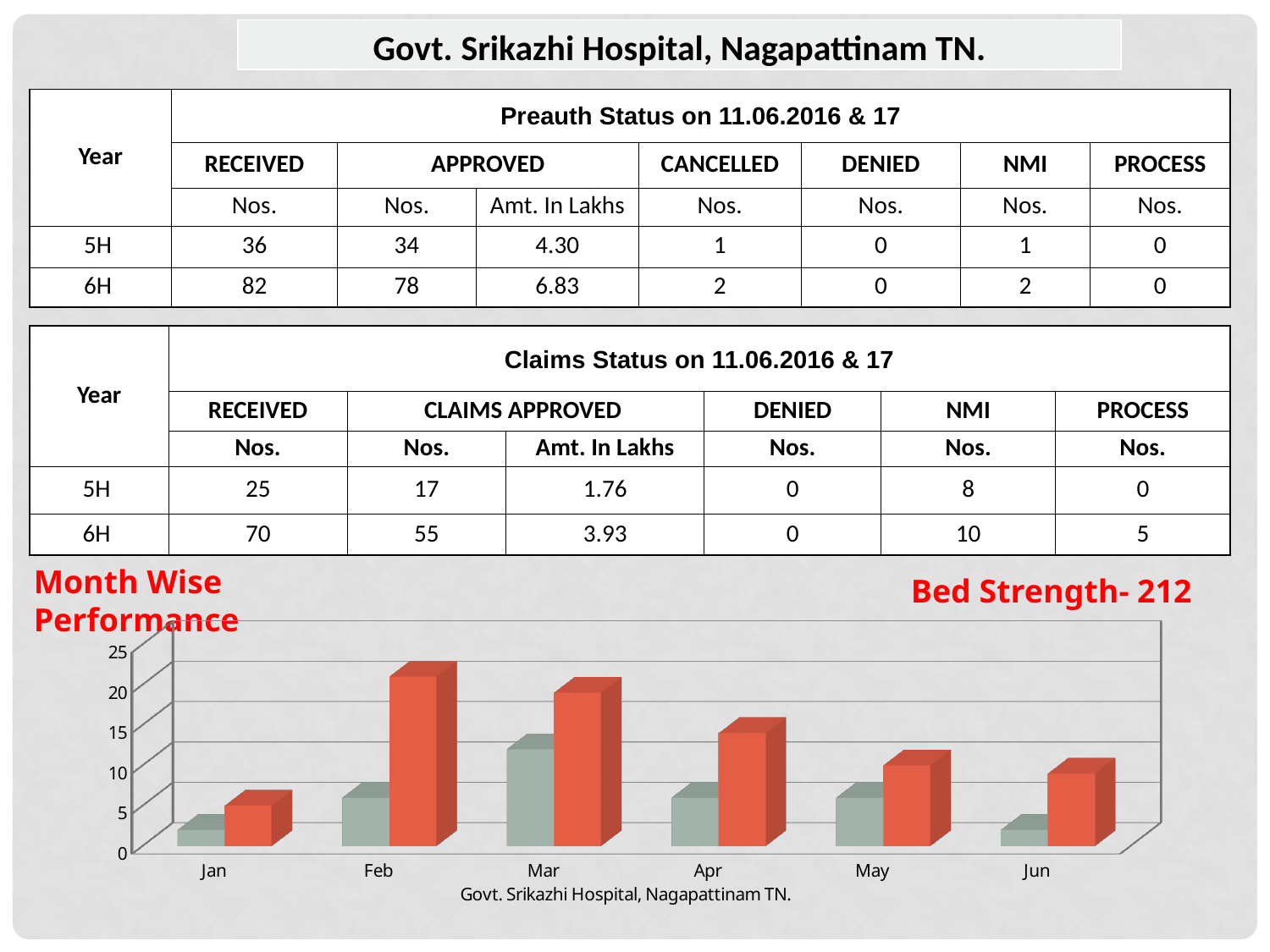
In the bar chart, which is larger for Mar: the red bar or the grey bar? the red bar What kind of chart is shown at the bottom of the slide? bar chart Which month has the shortest red bar in the bar chart? Jan Is the value of the grey bar for Mar greater or less than 10? greater How many months are shown on the x axis of the bar chart? 6 Is the value of the grey bar for Jun greater or less than 5? less Is the value of the red bar for Jan greater or less than 10? less What heading in red text appears above the bar chart on the left? Month Wise Performance Which month has the tallest grey bar in the bar chart? Mar In the bar chart, which month has the larger grey bar: Feb or Mar? Mar What is the title printed below the bar chart's x axis? Govt. Srikazhi Hospital, Nagapattinam TN.